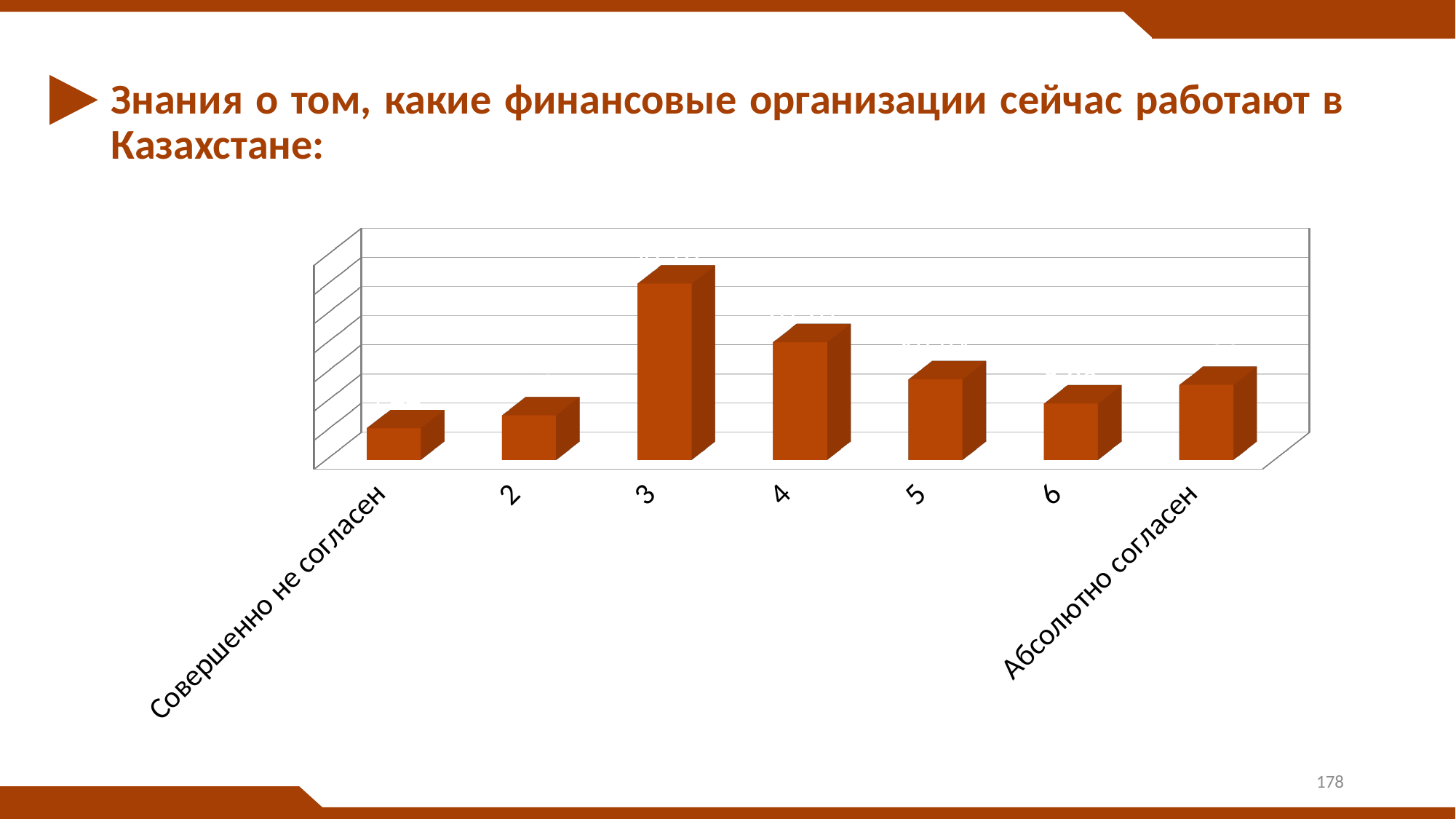
Which is larger, the value for category 6 or the value for "Абсолютно согласен"? Абсолютно согласен How many categories are shown on the x axis of the chart? 7 Which category has the highest bar in the chart? 3 Which is larger, the value for category 3 or the value for category 4? 3 Which category has the lowest bar in the chart? Совершенно не согласен What is the label of the first category on the x axis? Совершенно не согласен Do the values rise or fall from category 3 to category 6? fall What kind of chart is shown on the slide? bar chart Which is larger, the value for category 5 or the value for category 6? 5 What is the title of the slide containing the chart? Знания о том, какие финансовые организации сейчас работают в Казахстане: